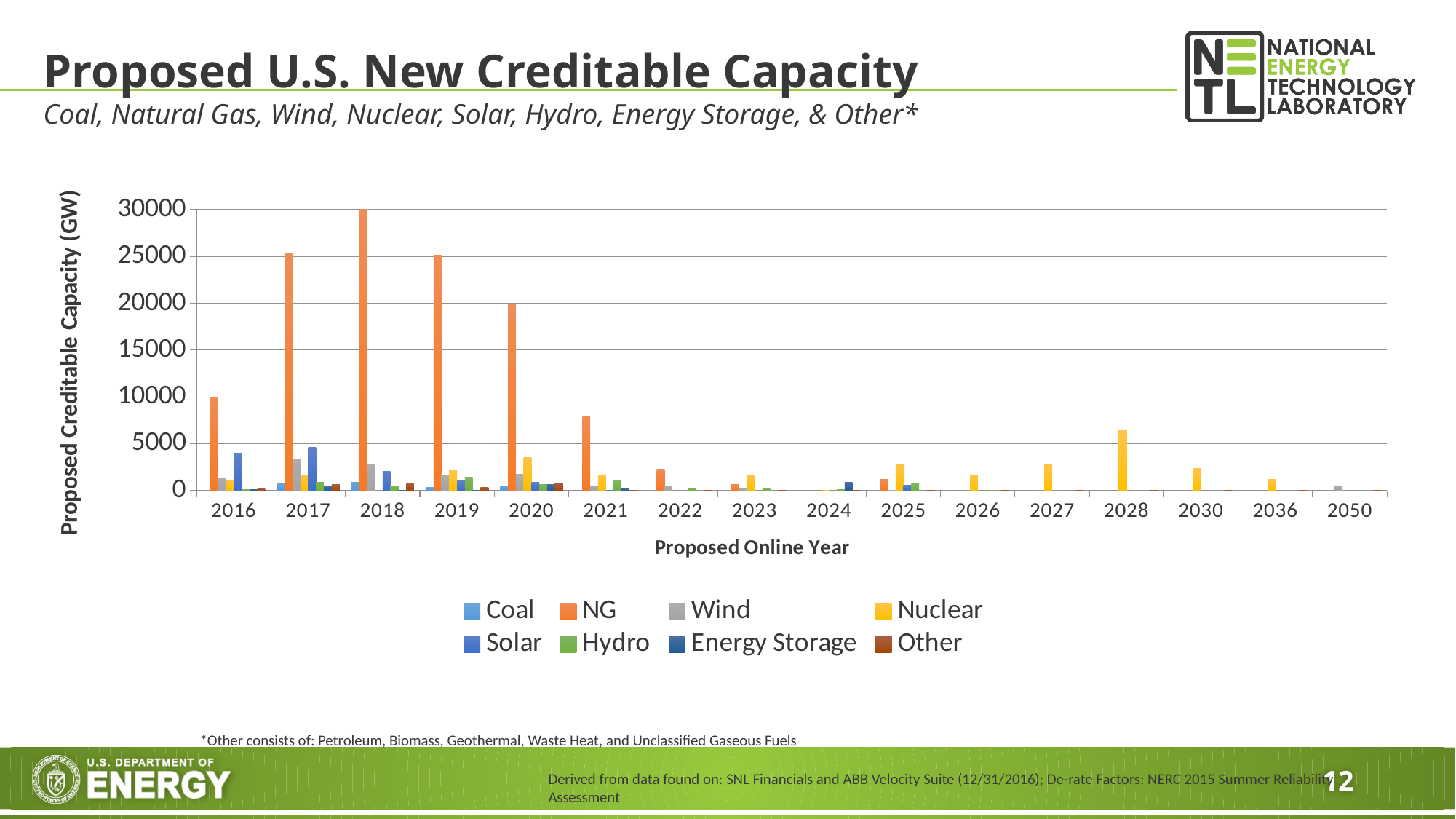
What is the title of the x axis? Proposed Online Year Which is larger, the Nuclear value for 2028 or the Nuclear value for 2027? 2028 In which year is the NG bar the highest? 2018 Do the NG values rise or fall from 2018 to 2022? fall How many proposed online years are shown on the x axis? 16 Is the NG value for 2018 greater or less than 25000? greater Is the Solar value for 2016 greater or less than 5000? less Which is larger, the NG value for 2017 or the NG value for 2020? 2017 In which year is the Nuclear bar the highest? 2028 Is the NG value for 2021 greater or less than 5000? greater What kind of chart is shown on the slide? bar chart How many series does the legend list? 8